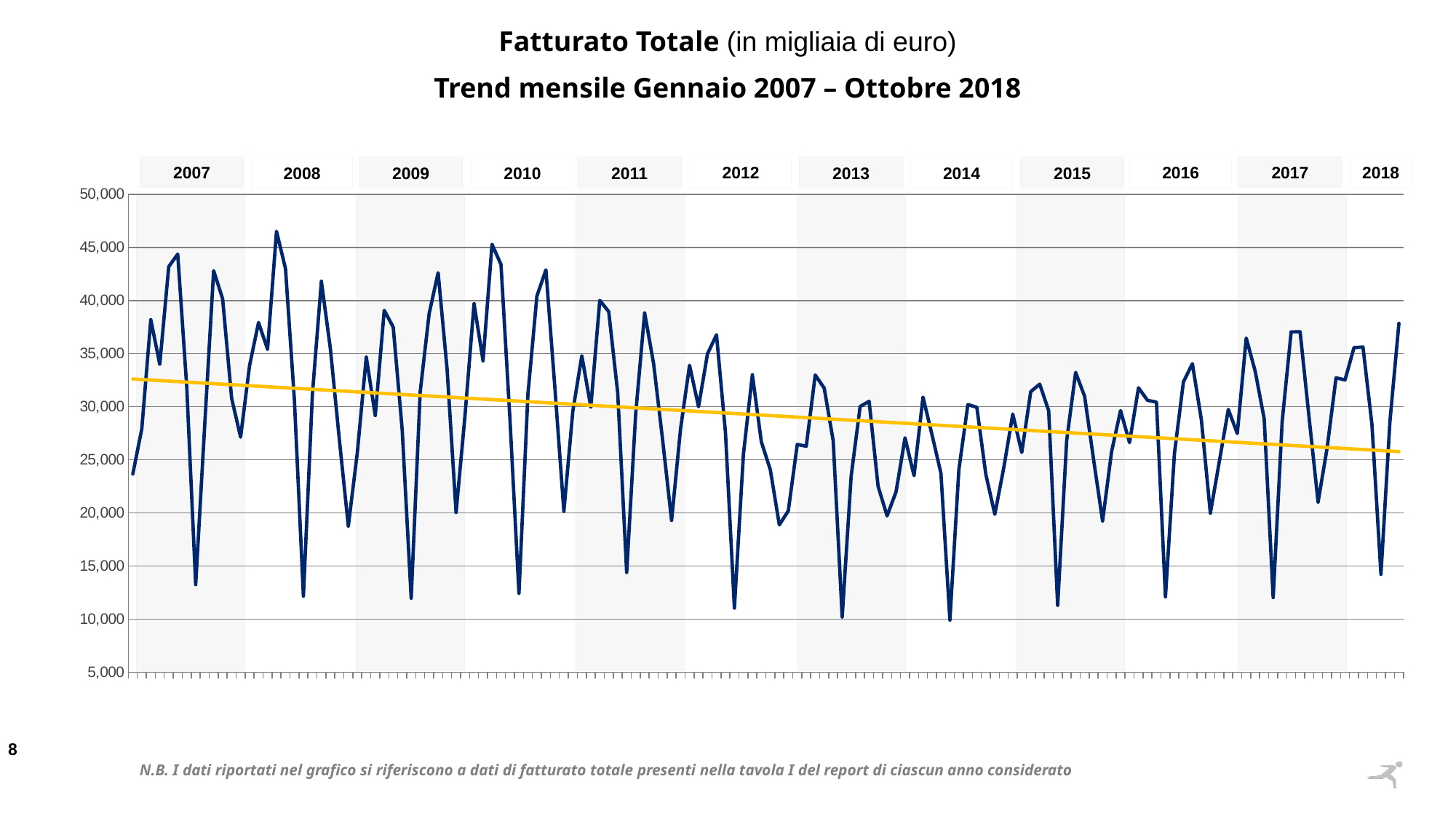
Which is higher: the highest peak of the blue line in 2011 or in 2015? 2011 Is the yellow trend line at the end of 2018 greater or less than 30,000? less How many years are labelled along the top of the chart? 12 In which year does the blue line reach its highest peak? 2008 Is the last plotted value (October 2018) greater or less than 35,000? greater Is the highest peak of the blue line in 2016 greater or less than 35,000? less Which is higher: the highest peak of the blue line in 2007 or in 2017? 2007 What is the title of the chart? Fatturato Totale (in migliaia di euro) – Trend mensile Gennaio 2007 – Ottobre 2018 What kind of chart is shown on the slide? line chart Does the yellow trend line rise or fall from 2007 to 2018? fall